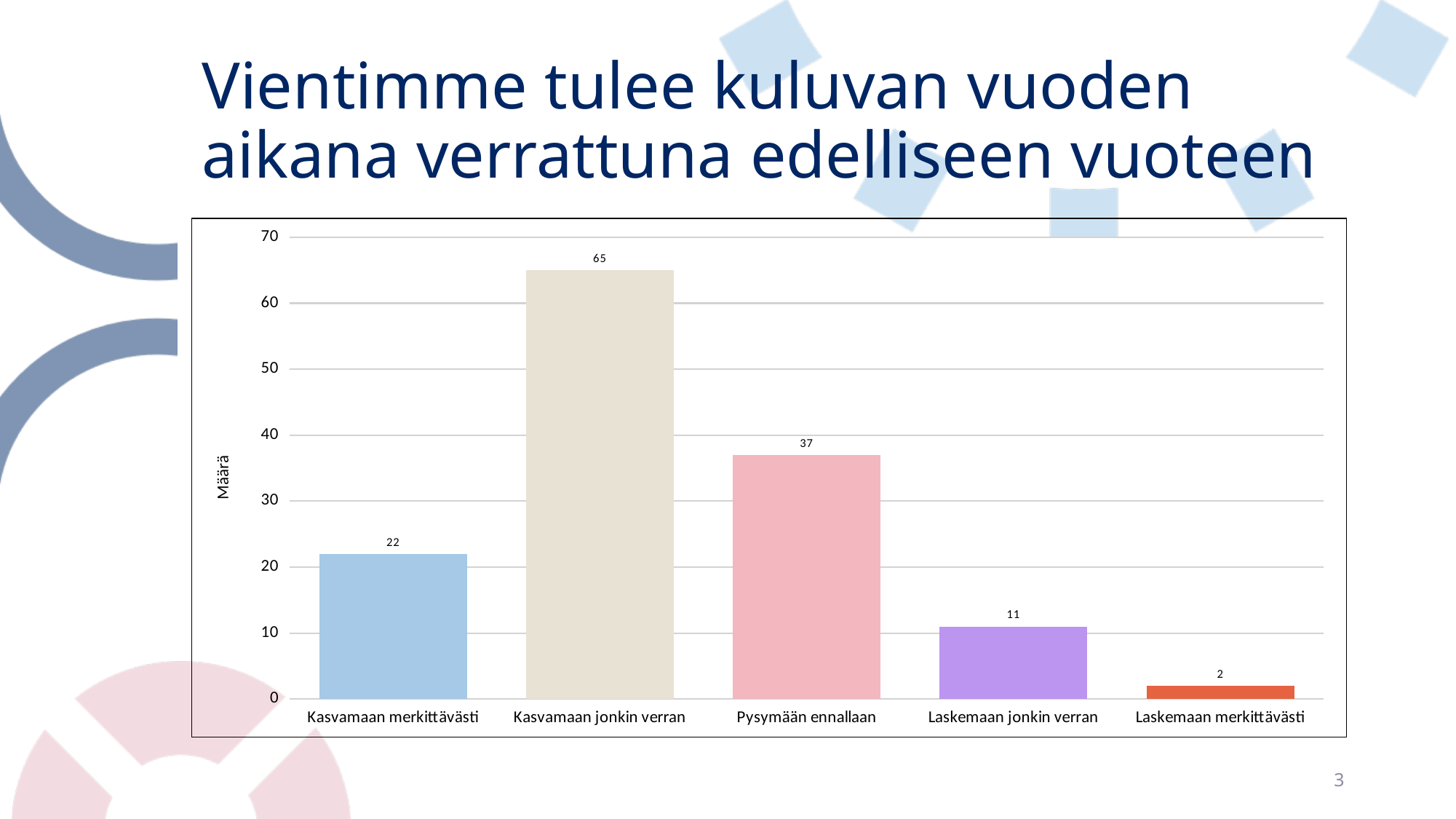
What is the value for "Laskemaan merkittävästi"? 2 What is the difference between the values for "Kasvamaan merkittävästi" and "Laskemaan jonkin verran"? 11 What kind of chart is shown on the slide? bar chart Which category has the lowest value? Laskemaan merkittävästi How many categories are shown on the x axis? 5 Which is larger, the value for "Kasvamaan merkittävästi" or "Laskemaan jonkin verran"? Kasvamaan merkittävästi Is the value for "Pysymään ennallaan" greater or less than 40? less Which category has the highest value? Kasvamaan jonkin verran What is the label of the vertical axis? Määrä What is the value for "Kasvamaan jonkin verran"? 65 What is the difference between the values for "Kasvamaan jonkin verran" and "Pysymään ennallaan"? 28 What is the value for "Pysymään ennallaan"? 37